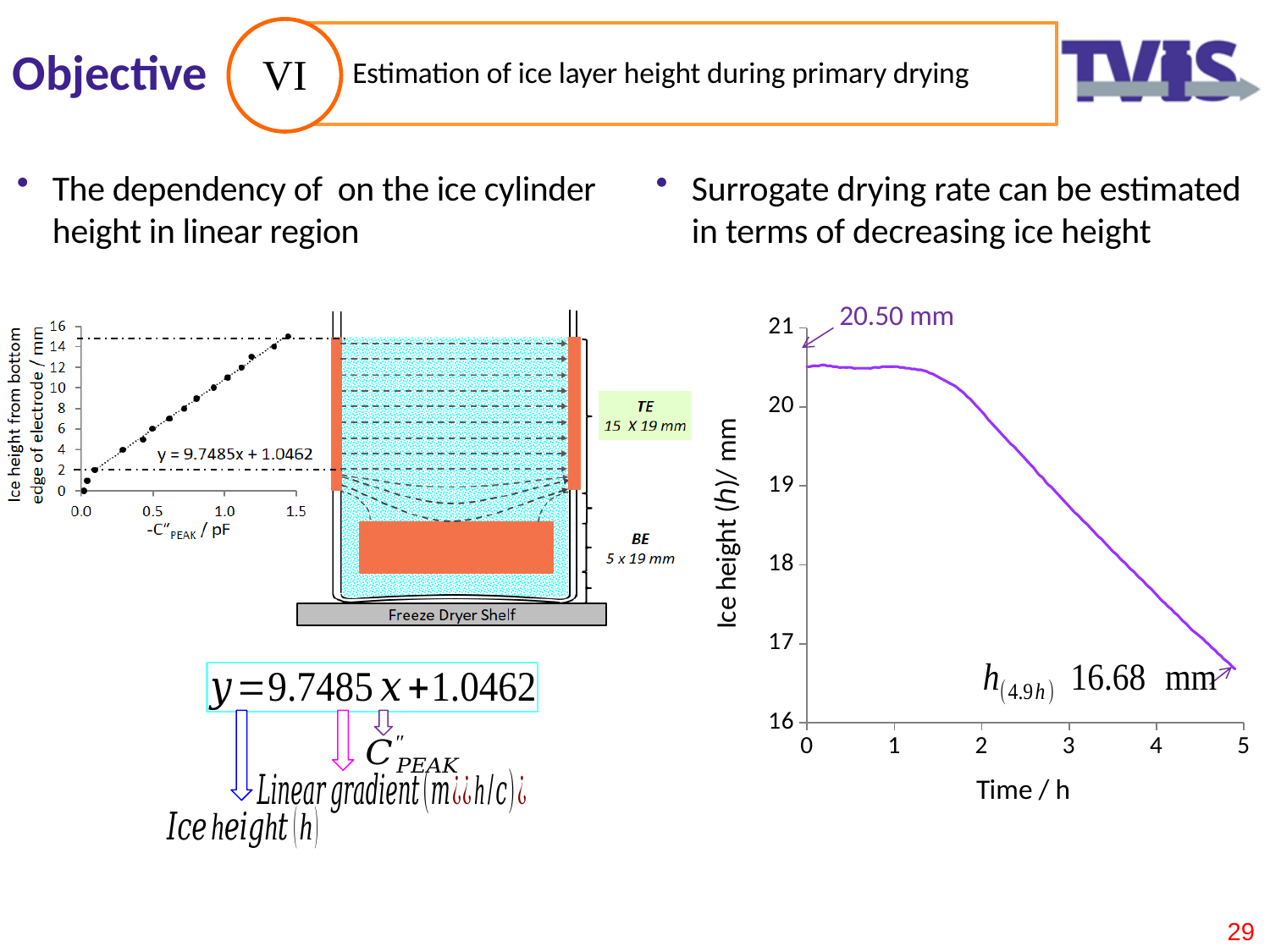
In the right chart (Ice height vs Time), is the ice height at 1 h greater or less than 20 mm? greater What kind of chart is the right chart (Ice height vs Time)? line chart In the left chart (Ice height vs -C''PEAK), does the ice height rise or fall as -C''PEAK increases? rise In the right chart (Ice height vs Time), what is the labelled ice height at 4.9 h? 16.68 mm In the right chart (Ice height vs Time), what is the x-axis label? Time / h In the left chart (Ice height vs -C''PEAK), what is the trendline equation shown? y = 9.7485x + 1.0462 In the right chart (Ice height vs Time), is the ice height at 3 h greater or less than 19 mm? less In the left chart (Ice height vs -C''PEAK), what is the x-axis label? -C''PEAK / pF In the right chart (Ice height vs Time), by how much does the ice height decrease from the labelled start value (20.50 mm) to the labelled value at 4.9 h (16.68 mm)? 3.82 mm What kind of chart is the left chart (Ice height vs -C''PEAK)? scatter plot In the right chart (Ice height vs Time), what is the labelled ice height at the start of drying? 20.50 mm In the right chart (Ice height vs Time), does the ice height rise or fall as time increases? fall